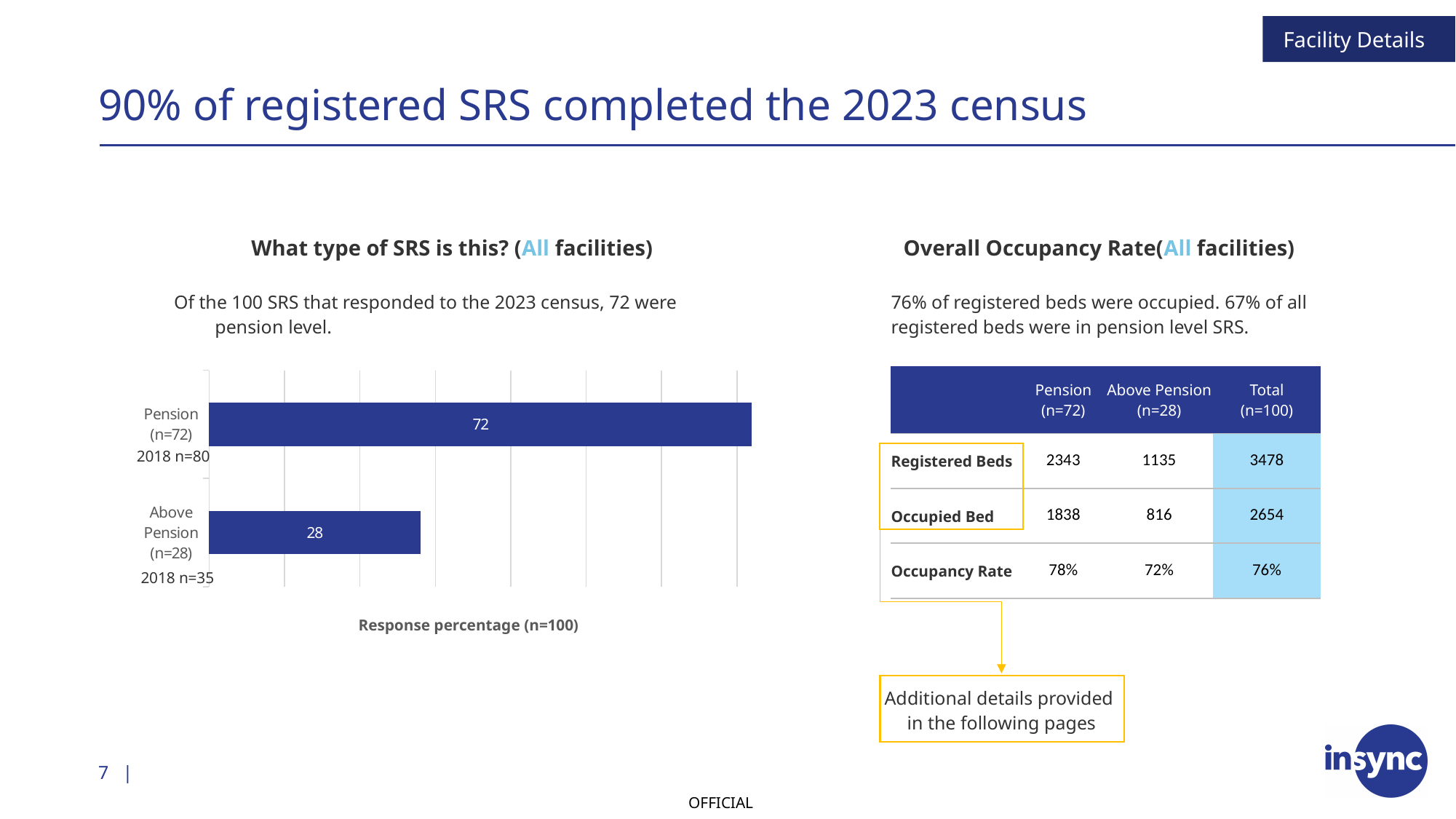
What is the title of the bar chart? What type of SRS is this? (All facilities) Which category has the highest value in the bar chart? Pension (n=72) What kind of chart is shown on the slide? Bar chart How many categories are shown in the bar chart? 2 What is the axis label shown below the bar chart? Response percentage (n=100) What is the difference between the Pension and Above Pension values in the bar chart? 44 What is the total of the two bar values in the bar chart? 100 Which category has the lowest value in the bar chart? Above Pension (n=28) What is the value for Pension (n=72) in the bar chart? 72 What is the value for Above Pension (n=28) in the bar chart? 28 Which is larger in the bar chart, the value for Pension or for Above Pension? Pension